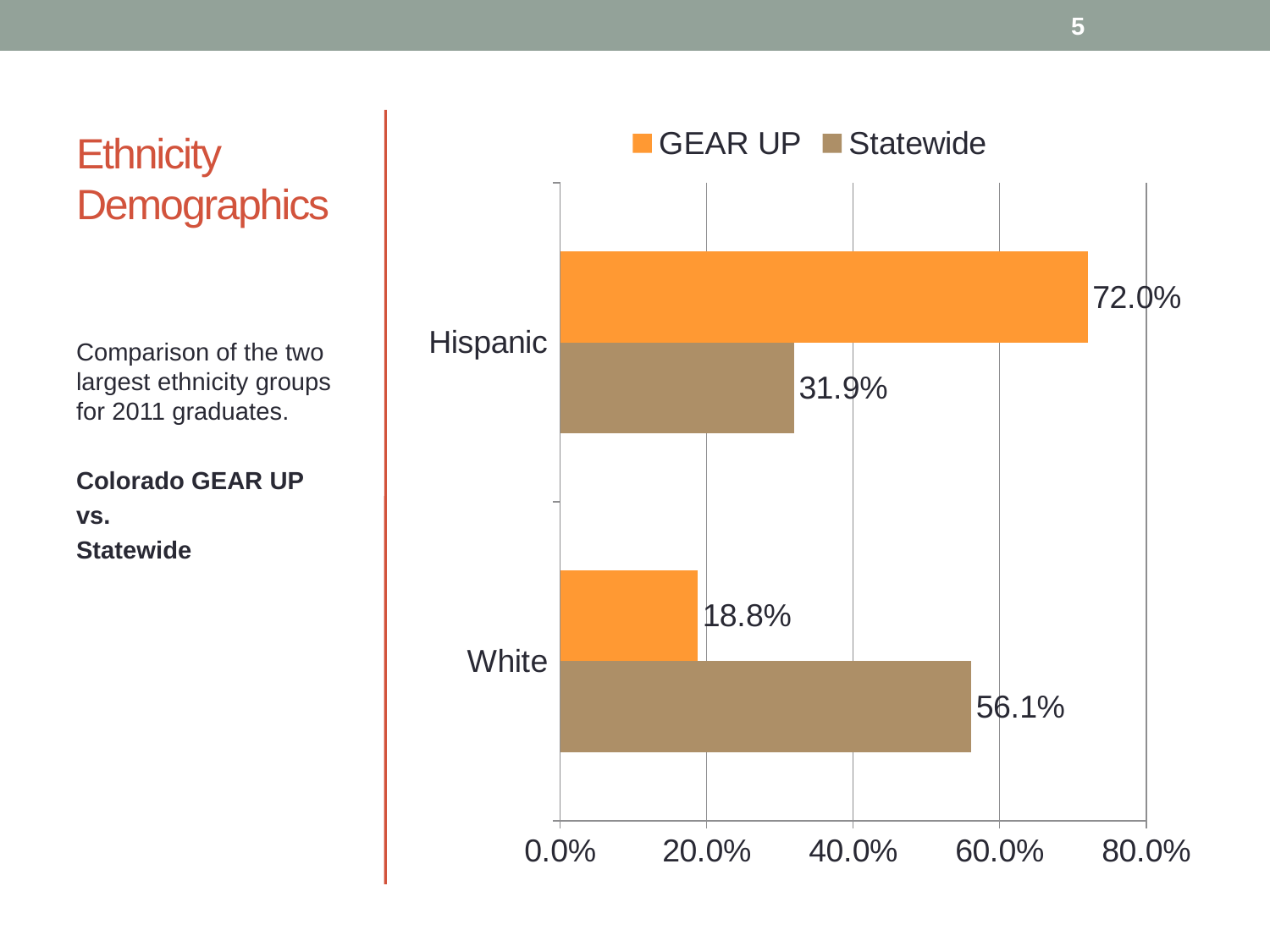
Which category has the lowest Statewide value? Hispanic What is the difference between the GEAR UP and Statewide values for Hispanic? 40.1% What is the GEAR UP value for White? 18.8% What is the Statewide value for White? 56.1% What is the Statewide value for Hispanic? 31.9% How many series does the legend list? 2 Which is larger for White: the GEAR UP value or the Statewide value? Statewide Which category has the highest GEAR UP value? Hispanic What kind of chart is shown on the slide? Bar chart How many ethnicity categories are shown on the chart? 2 What is the GEAR UP value for Hispanic? 72.0% Is the GEAR UP value for Hispanic greater or less than 60.0%? greater